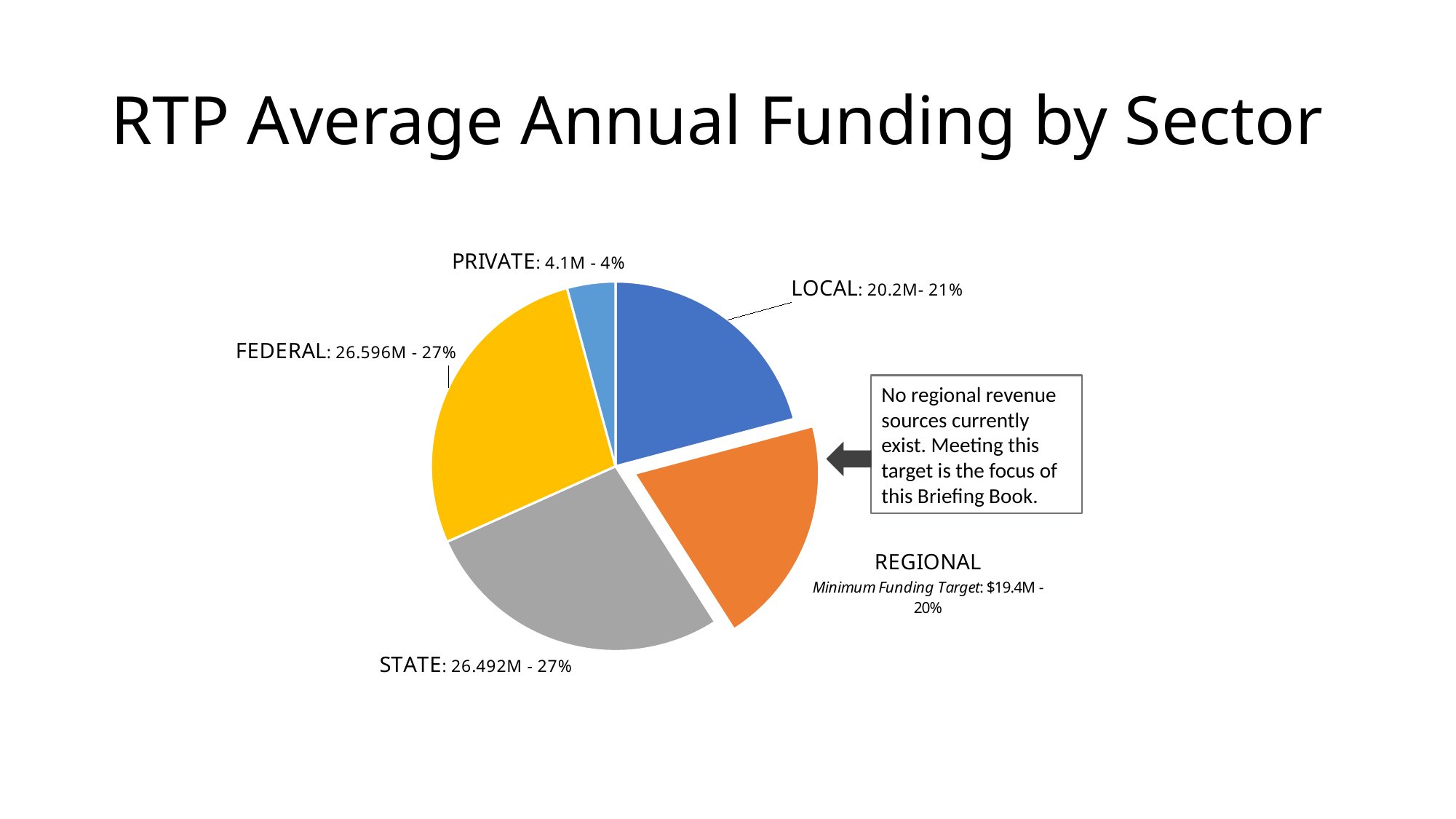
Which sector has the smallest share of the pie? PRIVATE What kind of chart is shown on the slide? pie chart What percentage share of the pie does the LOCAL sector have? 21% How many sectors (slices) does the pie chart show? 5 What percentage share of the pie does the PRIVATE sector have? 4% What is the difference between the LOCAL funding amount and the PRIVATE funding amount? 16.1M Which slice is pulled out (separated) from the rest of the pie? REGIONAL What is the chart title? RTP Average Annual Funding by Sector What is the funding amount shown for the STATE sector? 26.492M What is the average annual funding amount for the LOCAL sector? 20.2M What is the minimum funding target shown for the REGIONAL sector? $19.4M What is the funding amount shown for the FEDERAL sector? 26.596M